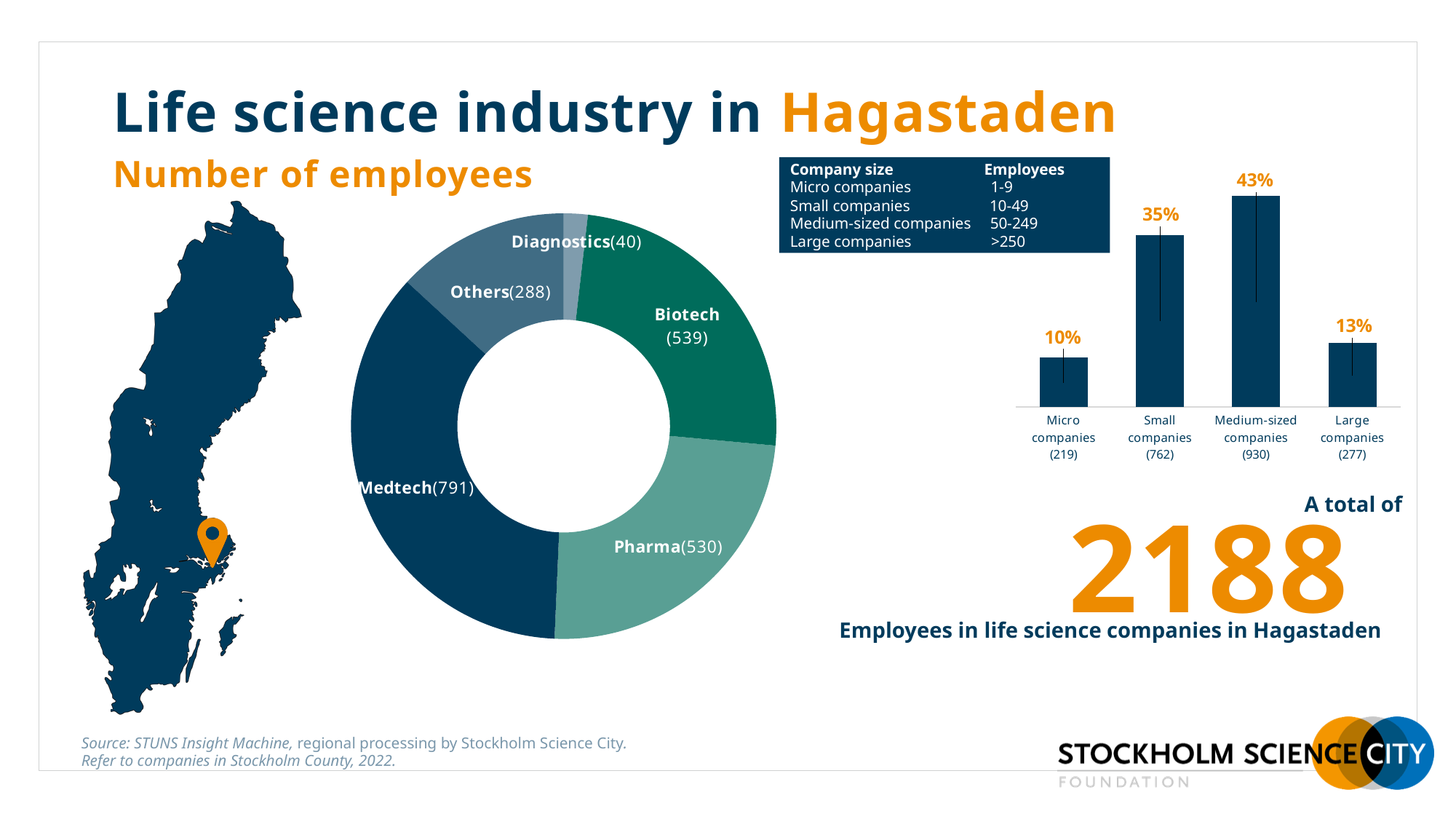
In the donut chart, how many sectors are shown? 5 In the donut chart, which sector has the fewest employees? Diagnostics In the donut chart, how many employees are in Diagnostics? 40 What kind of chart is the 'Number of employees' chart? Donut (pie) chart In the bar chart by company size, how many employees are in small companies? 762 In the donut chart, which sector has the most employees? Medtech In the donut chart, how many employees are in Medtech? 791 In the bar chart by company size, what is the difference in percentage points between medium-sized and small companies? 8 In the bar chart by company size, which company size has the lowest share of employees? Micro companies In the bar chart by company size, which is larger: the share for large companies or for micro companies? Large companies In the donut chart, what is the difference in employees between Biotech and Pharma? 9 In the bar chart by company size, what percentage of employees are in medium-sized companies? 43%